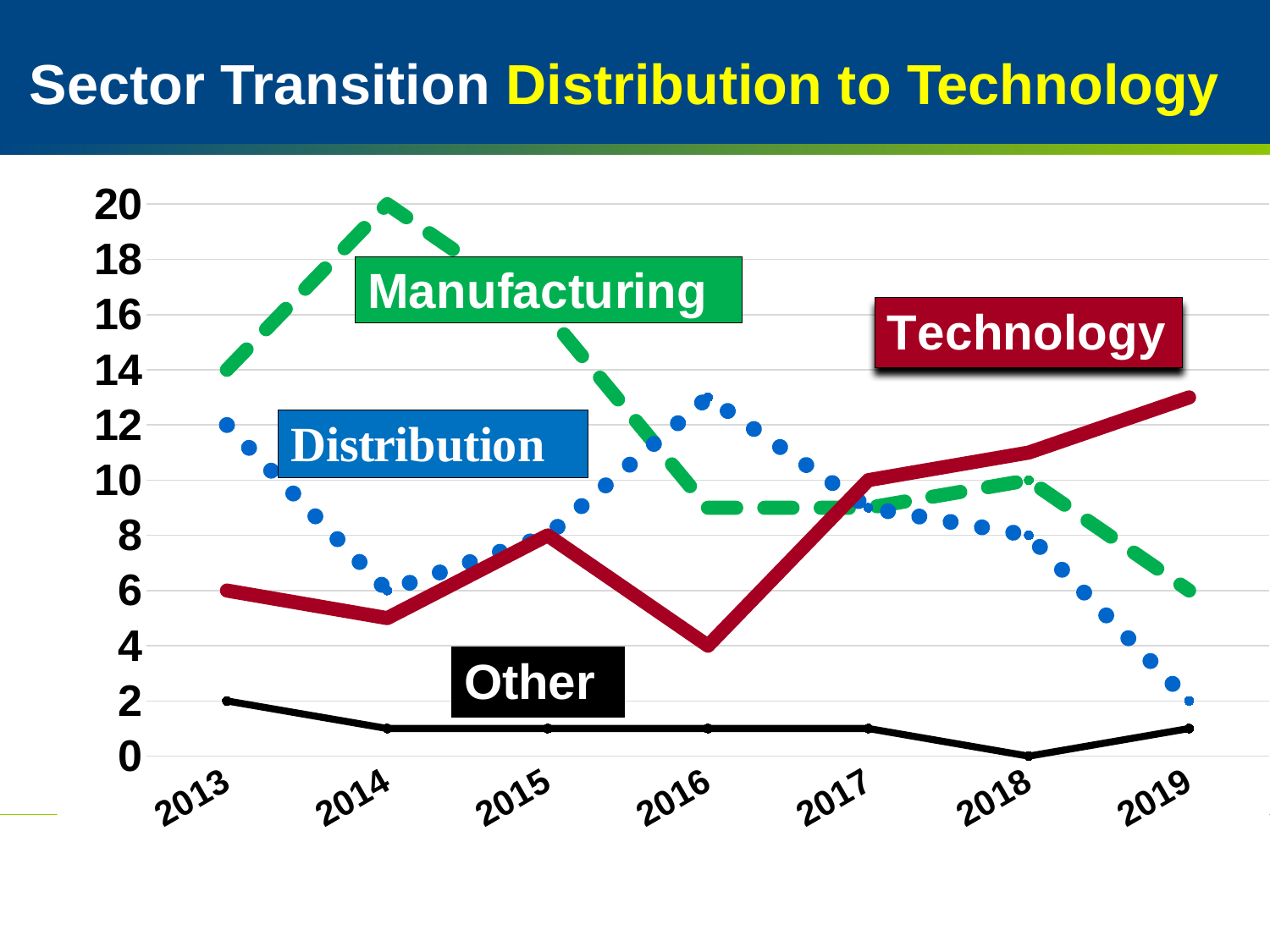
In which year is Technology at its highest? 2019 How many years are shown on the x axis? 7 What is the Technology value in 2016? 4 How many series are plotted on the chart? 4 What is the Other value in 2018? 0 In 2019, which is larger, Technology or Manufacturing? Technology What is the Distribution value in 2019? 2 Is the Technology value in 2019 greater or less than 10? greater In which year is Distribution at its lowest? 2019 In which year is Manufacturing at its highest? 2014 What kind of chart is shown on the slide? Line chart What is the Manufacturing value in 2014? 20